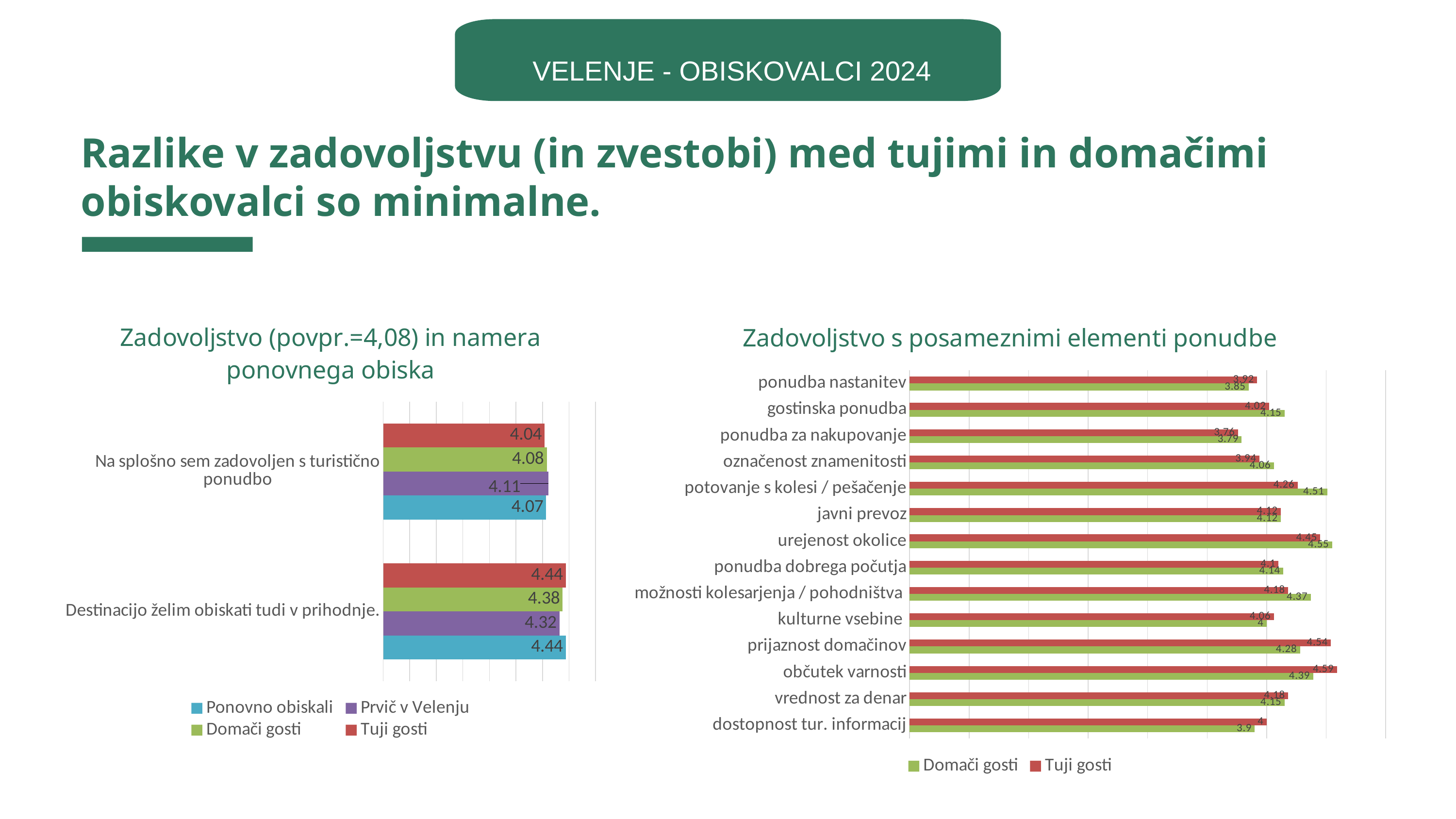
What kind of chart is 'Zadovoljstvo s posameznimi elementi ponudbe'? Bar chart In the chart 'Zadovoljstvo (povpr.=4,08) in namera ponovnega obiska', what is the value for 'Tuji gosti' for 'Destinacijo želim obiskati tudi v prihodnje.'? 4.44 In the chart 'Zadovoljstvo (povpr.=4,08) in namera ponovnega obiska', what is the difference between 'Domači gosti' and 'Prvič v Velenju' for 'Destinacijo želim obiskati tudi v prihodnje.'? 0.06 How many series does the legend of the chart 'Zadovoljstvo (povpr.=4,08) in namera ponovnega obiska' list? 4 In the chart 'Zadovoljstvo (povpr.=4,08) in namera ponovnega obiska', which series has the lowest value for 'Destinacijo želim obiskati tudi v prihodnje.'? Prvič v Velenju In the chart 'Zadovoljstvo s posameznimi elementi ponudbe', which is larger for 'prijaznost domačinov': 'Domači gosti' or 'Tuji gosti'? Tuji gosti In the chart 'Zadovoljstvo (povpr.=4,08) in namera ponovnega obiska', what is the value for 'Prvič v Velenju' for 'Na splošno sem zadovoljen s turistično ponudbo'? 4.11 In the chart 'Zadovoljstvo s posameznimi elementi ponudbe', what is the value for 'Tuji gosti' for 'občutek varnosti'? 4.59 In the chart 'Zadovoljstvo s posameznimi elementi ponudbe', what is the difference between 'Domači gosti' and 'Tuji gosti' for 'občutek varnosti'? 0.2 In the chart 'Zadovoljstvo s posameznimi elementi ponudbe', which category has the highest value for 'Domači gosti'? urejenost okolice How many categories are shown in the chart 'Zadovoljstvo s posameznimi elementi ponudbe'? 14 In the chart 'Zadovoljstvo s posameznimi elementi ponudbe', what is the value for 'Domači gosti' for 'potovanje s kolesi / pešačenje'? 4.51